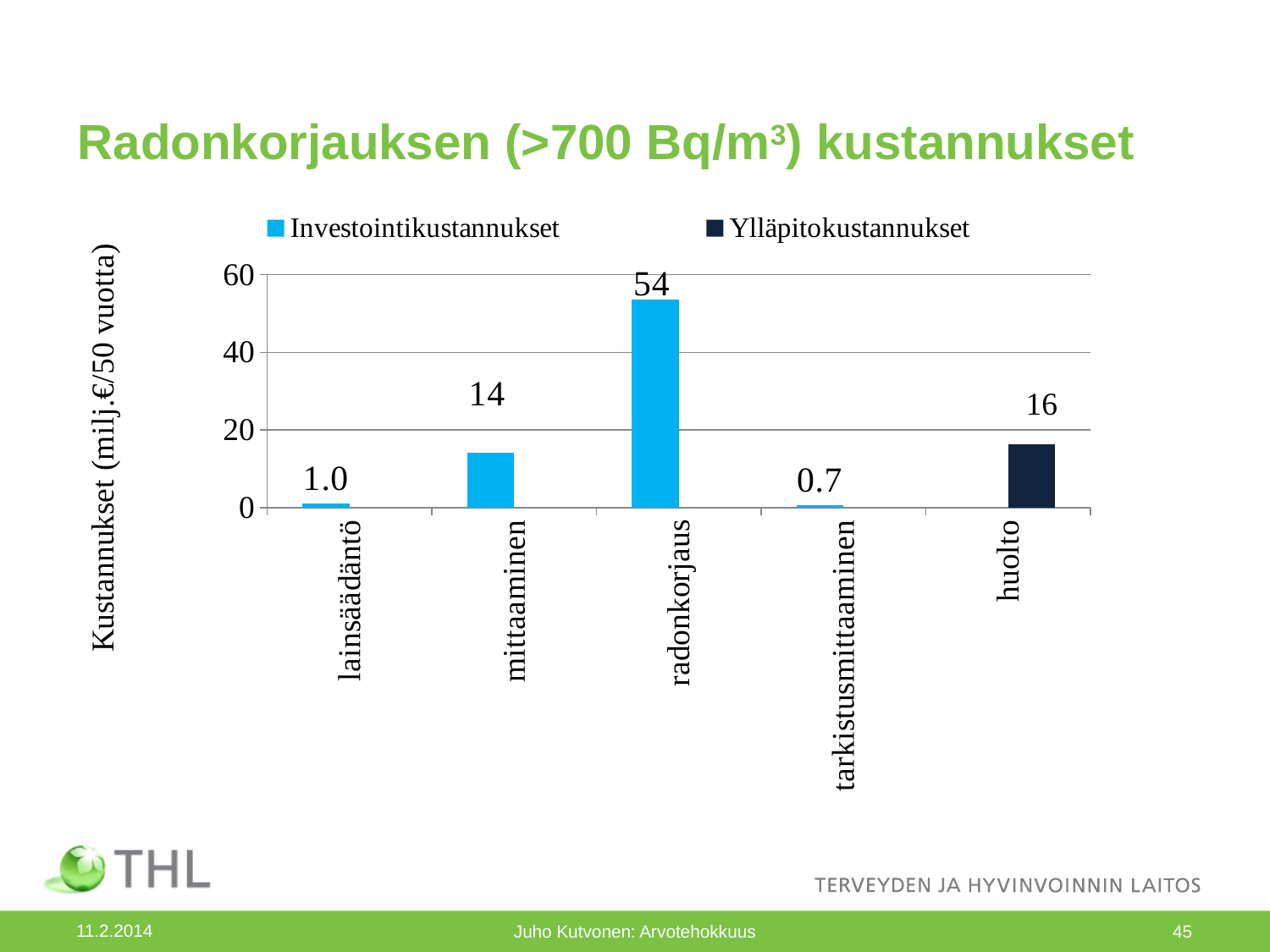
What is the difference between the values for radonkorjaus and huolto? 38 What is the value for huolto? 16 What is the value for mittaaminen? 14 What kind of chart is shown on the slide? bar chart How many categories are shown on the x axis? 5 Which is larger, the value for mittaaminen or the value for huolto? huolto How many series does the legend list? 2 What is the value for radonkorjaus? 54 Which category has the highest value? radonkorjaus What is the value for lainsäädäntö? 1.0 What is the value for tarkistusmittaaminen? 0.7 Which category has the lowest value? tarkistusmittaaminen